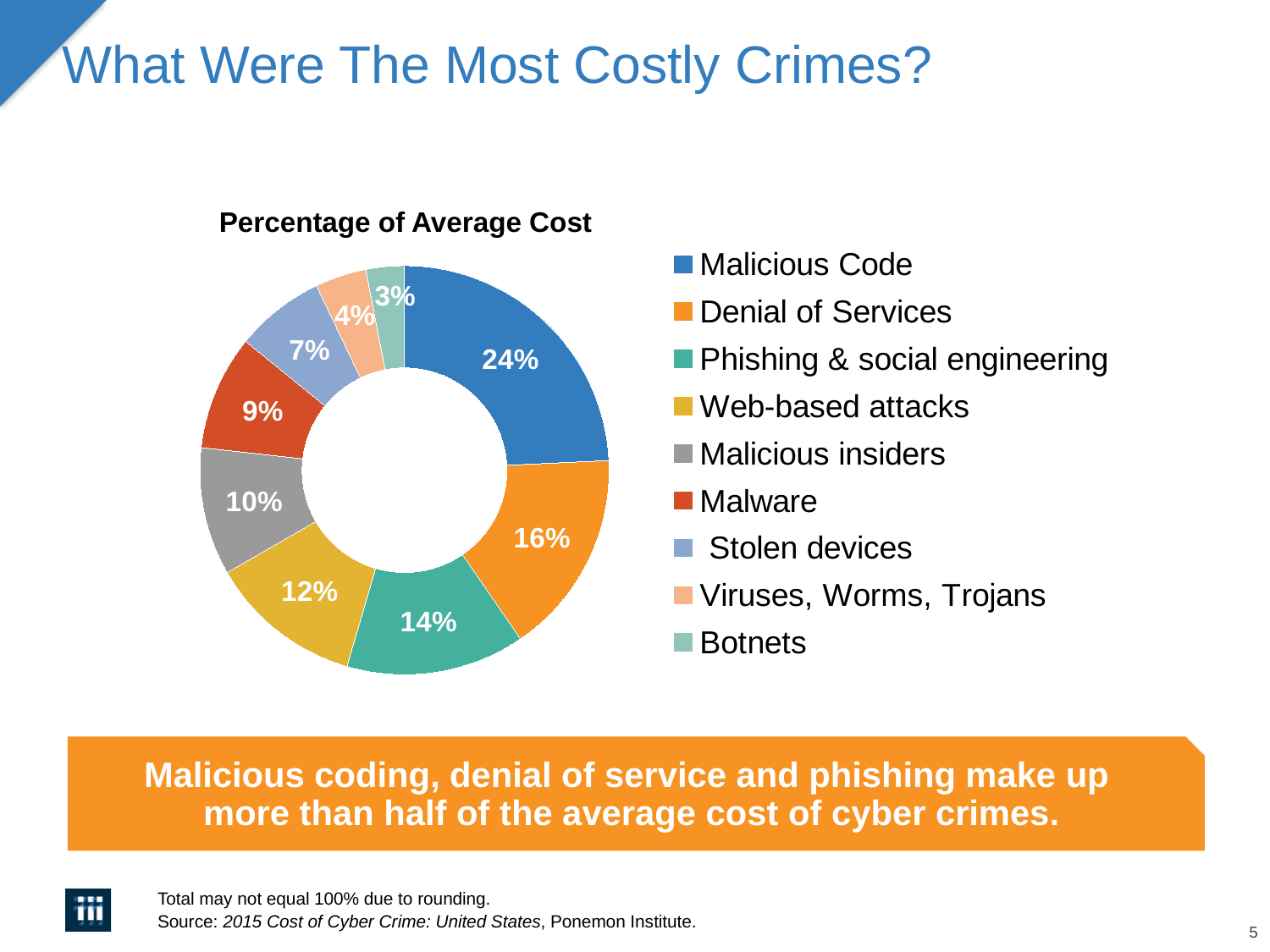
What percentage of average cost is attributed to Malicious Code? 24% What percentage of average cost is attributed to Denial of Services? 16% Which category accounts for the smallest share of average cost? Botnets What is the title of the chart? Percentage of Average Cost What percentage of average cost is attributed to Web-based attacks? 12% Which category accounts for the largest share of average cost? Malicious Code What percentage of average cost is attributed to Stolen devices? 7% How many categories are shown in the chart? 9 What is the combined share of Malicious Code, Denial of Services and Phishing & social engineering? 54% Which has a larger share of average cost, Malware or Malicious insiders? Malicious insiders What is the difference in percentage points between Malicious Code and Phishing & social engineering? 10 What kind of chart is shown on the slide? Pie chart (doughnut)